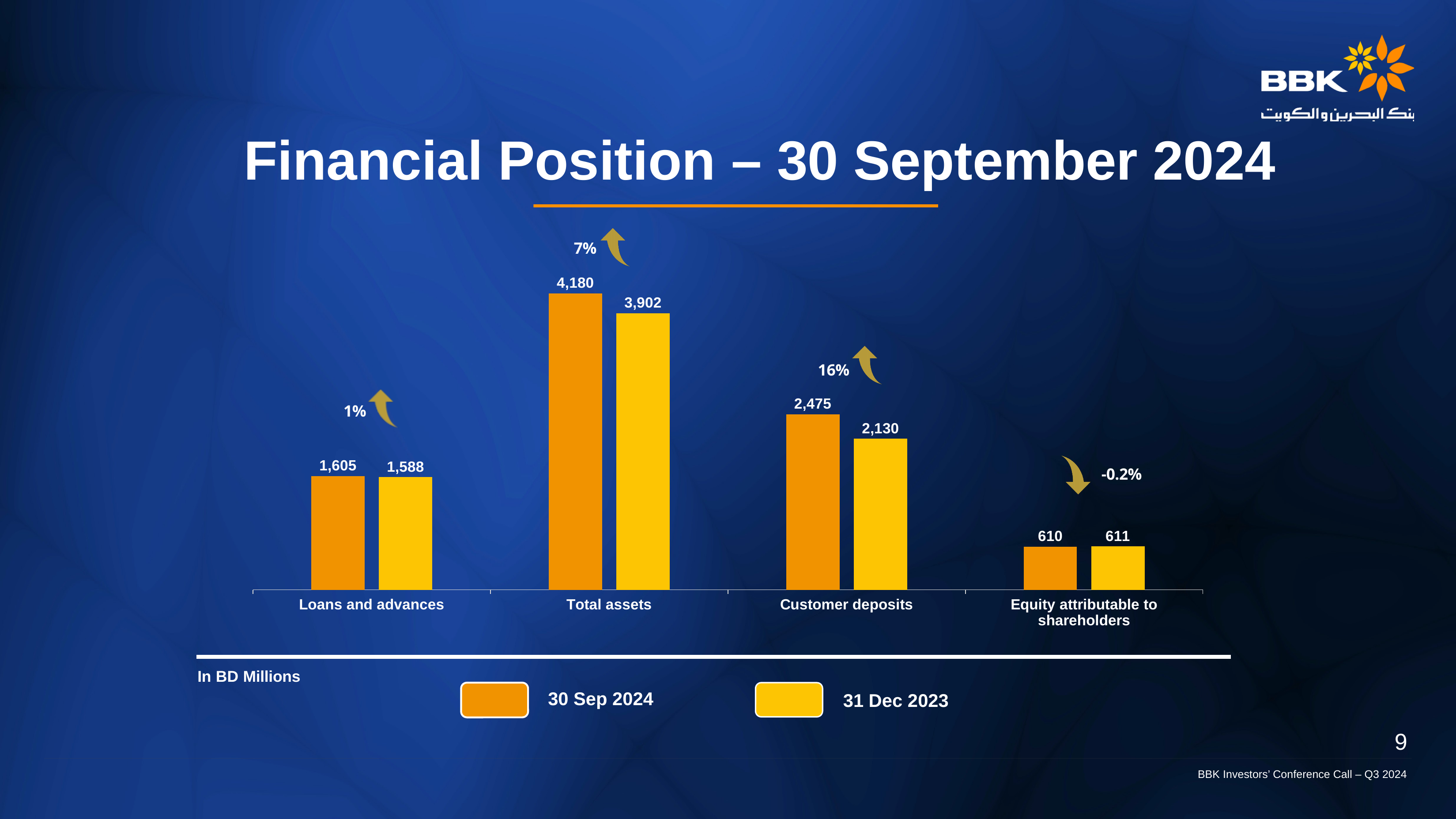
What is the value for Equity attributable to shareholders at 31 Dec 2023? 611 How many series does the legend list? 2 Which category has the lowest value for 31 Dec 2023? Equity attributable to shareholders How many categories are shown on the x axis? 4 What kind of chart is shown on the slide? Bar chart What is the difference between the 30 Sep 2024 and 31 Dec 2023 values for Total assets? 278 What is the value for Total assets at 30 Sep 2024? 4,180 Which is larger for Customer deposits: the 30 Sep 2024 value or the 31 Dec 2023 value? 30 Sep 2024 What is the value for Loans and advances at 30 Sep 2024? 1,605 What is the value for Customer deposits at 31 Dec 2023? 2,130 What is the difference between the 30 Sep 2024 and 31 Dec 2023 values for Customer deposits? 345 Which category has the highest value for 30 Sep 2024? Total assets